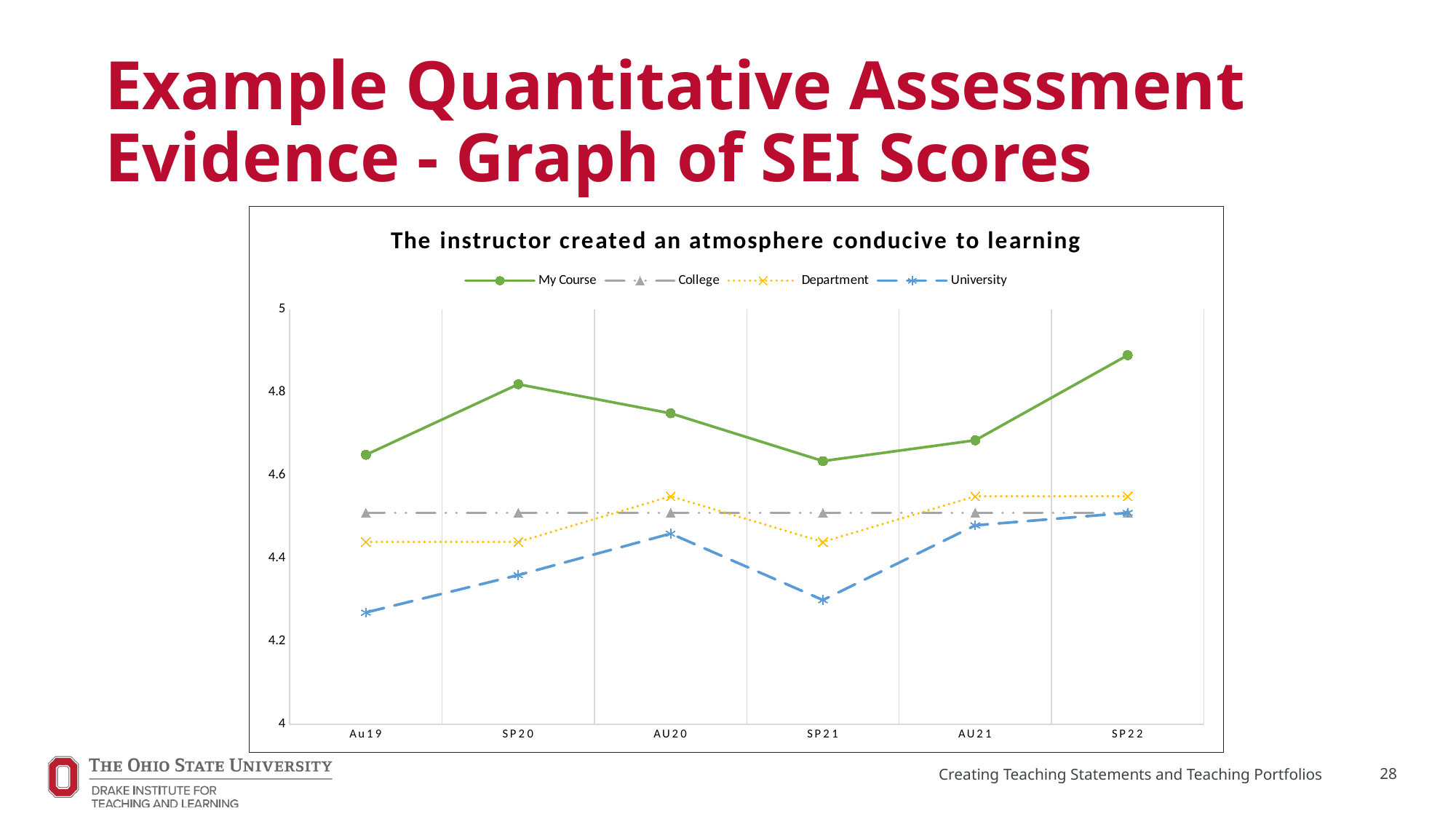
How many terms are shown along the x axis? 6 Does the University series rise or fall from Au19 to AU20? rise Is the Department value for AU20 greater or less than 4.6? less Is the University value for Au19 greater or less than 4.4? less Which series is drawn with a solid green line? My Course Is the My Course value for SP22 greater or less than 4.8? greater How many series does the legend list? 4 What kind of chart is shown on the slide? line chart At Au19, which is larger: the My Course value or the University value? My Course At which term does the My Course series reach its highest value? SP22 What is the title of the chart? The instructor created an atmosphere conducive to learning